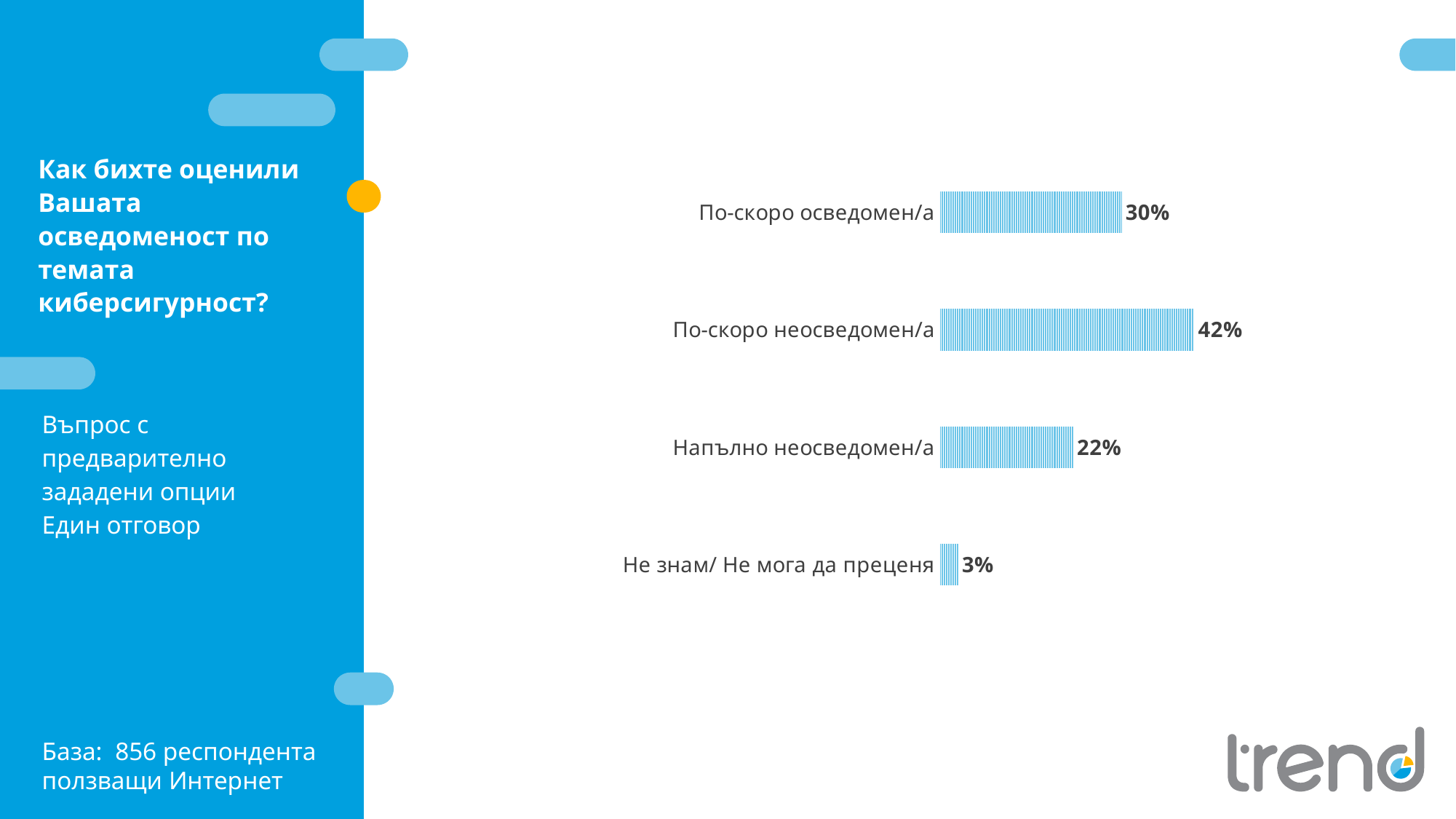
What is the value for "По-скоро осведомен/а"? 30% What is the question shown as the title on the left of the slide? Как бихте оценили Вашата осведоменост по темата киберсигурност? What is the value for "Не знам/ Не мога да преценя"? 3% Which is larger, the value for "Напълно неосведомен/а" or the value for "По-скоро осведомен/а"? По-скоро осведомен/а What is the difference between the values for "По-скоро осведомен/а" and "Напълно неосведомен/а"? 8% How many categories are shown in the chart? 4 What kind of chart is shown on the slide? Bar chart Which category has the lowest value? Не знам/ Не мога да преценя What is the value for "Напълно неосведомен/а"? 22% What is the value for "По-скоро неосведомен/а"? 42% What is the difference between the values for "По-скоро неосведомен/а" and "По-скоро осведомен/а"? 12% Which category has the highest value? По-скоро неосведомен/а